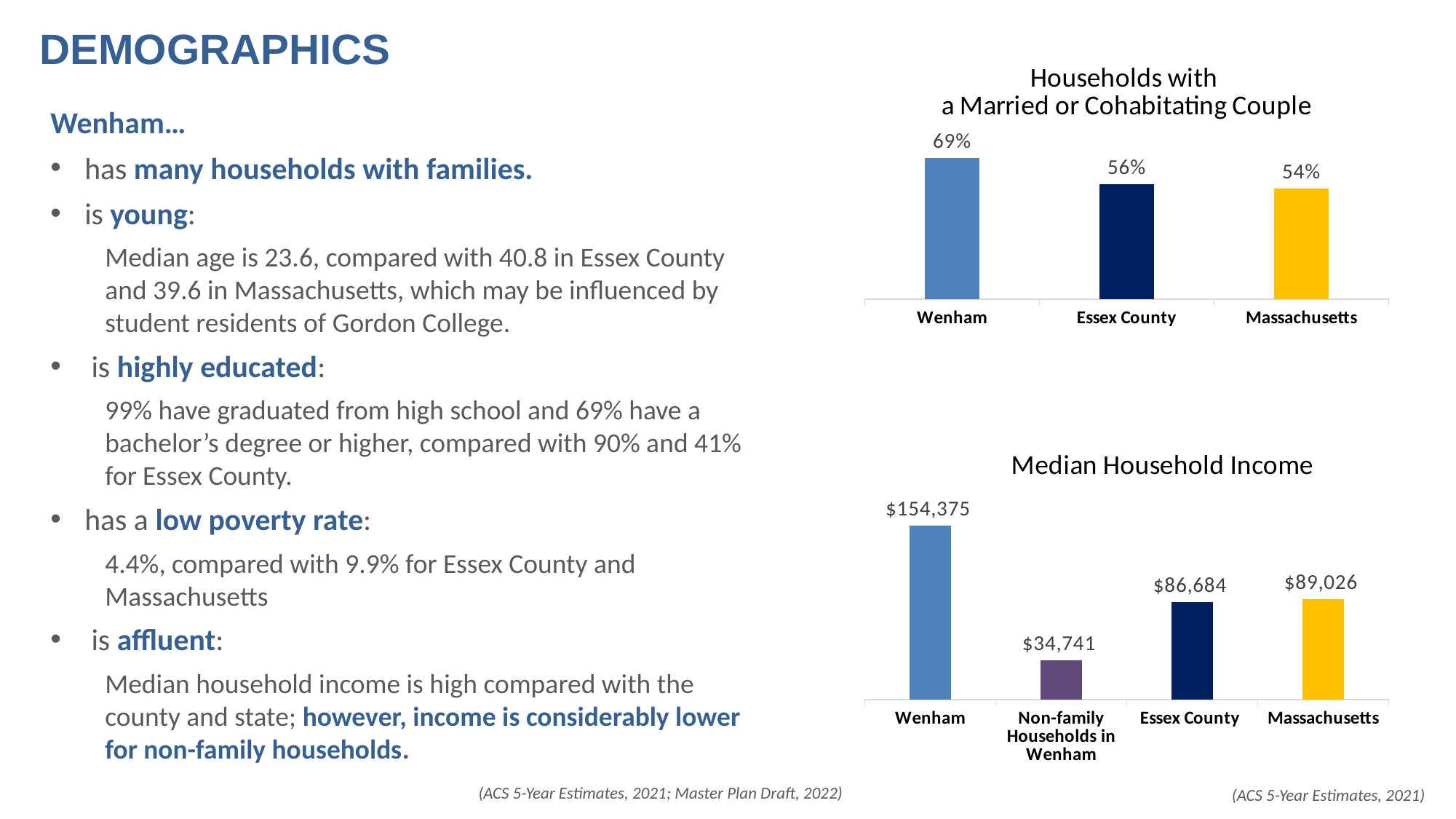
In the 'Median Household Income' chart, which category has the highest value? Wenham In the 'Median Household Income' chart, what is the difference between Massachusetts and Essex County? $2,342 In the 'Households with a Married or Cohabitating Couple' chart, what is the value for Wenham? 69% In the 'Median Household Income' chart, how many categories are shown? 4 In the 'Households with a Married or Cohabitating Couple' chart, what is the difference between Wenham and Essex County? 13% In the 'Median Household Income' chart, what is the value for Non-family Households in Wenham? $34,741 In the 'Median Household Income' chart, what is the value for Essex County? $86,684 In the 'Households with a Married or Cohabitating Couple' chart, which category has the lowest value? Massachusetts What kind of chart is the 'Households with a Married or Cohabitating Couple' chart? bar chart In the 'Households with a Married or Cohabitating Couple' chart, how many categories are shown? 3 In the 'Median Household Income' chart, what colour is the bar for Massachusetts? yellow In the 'Median Household Income' chart, which category has the lowest value? Non-family Households in Wenham